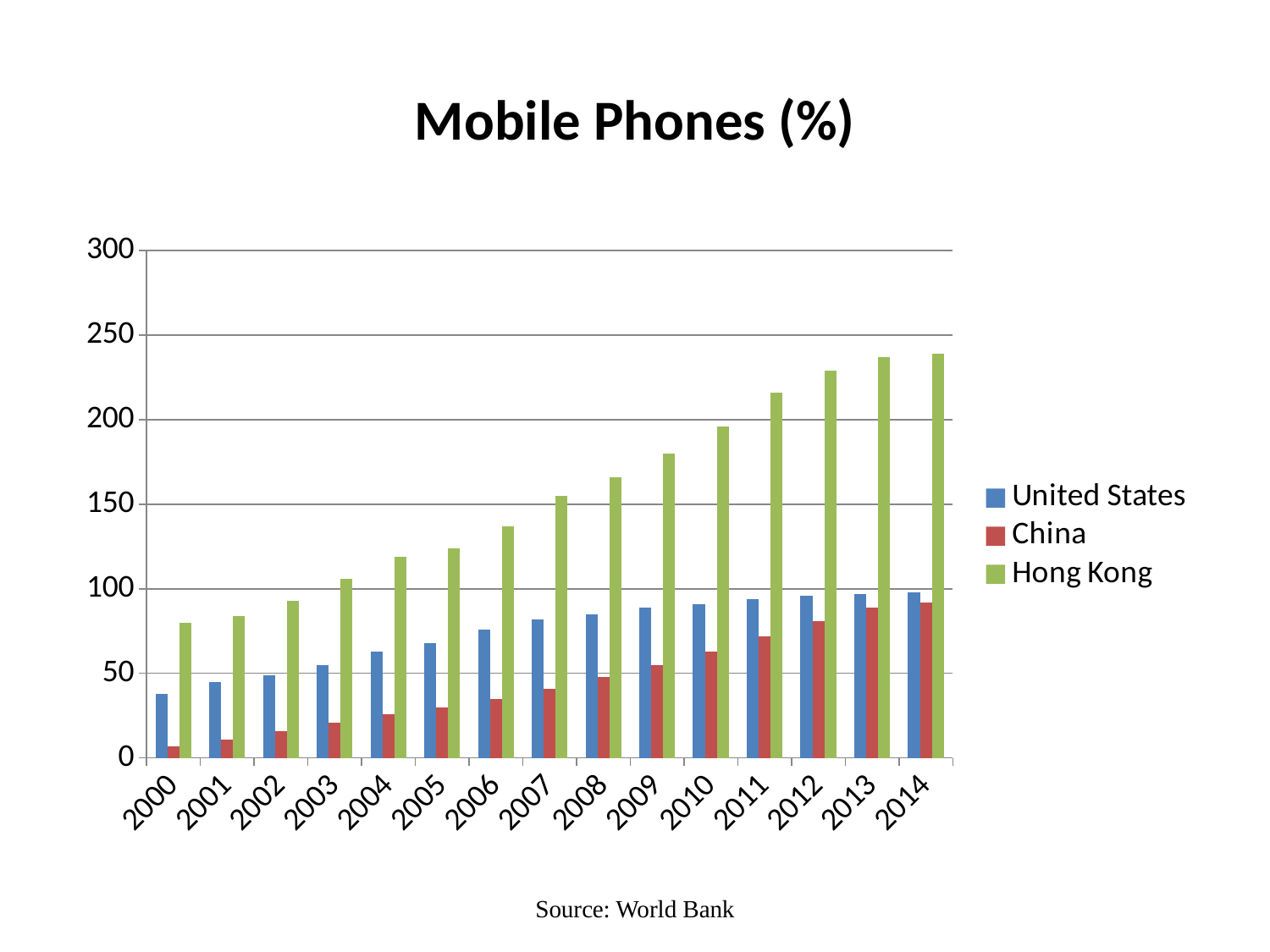
Is the value for Hong Kong in 2000 greater or less than 100? less Which series has the lowest value in 2000? China Is the value for Hong Kong in 2014 greater or less than 200? greater Is the value for China in 2000 greater or less than 50? less Do the values for Hong Kong rise or fall from 2000 to 2014? rise How many series does the legend list? 3 Which series has the highest value in 2014? Hong Kong What kind of chart is shown on the slide? bar chart In 2000, which is larger, the value for United States or the value for China? United States How many years are shown along the x axis? 15